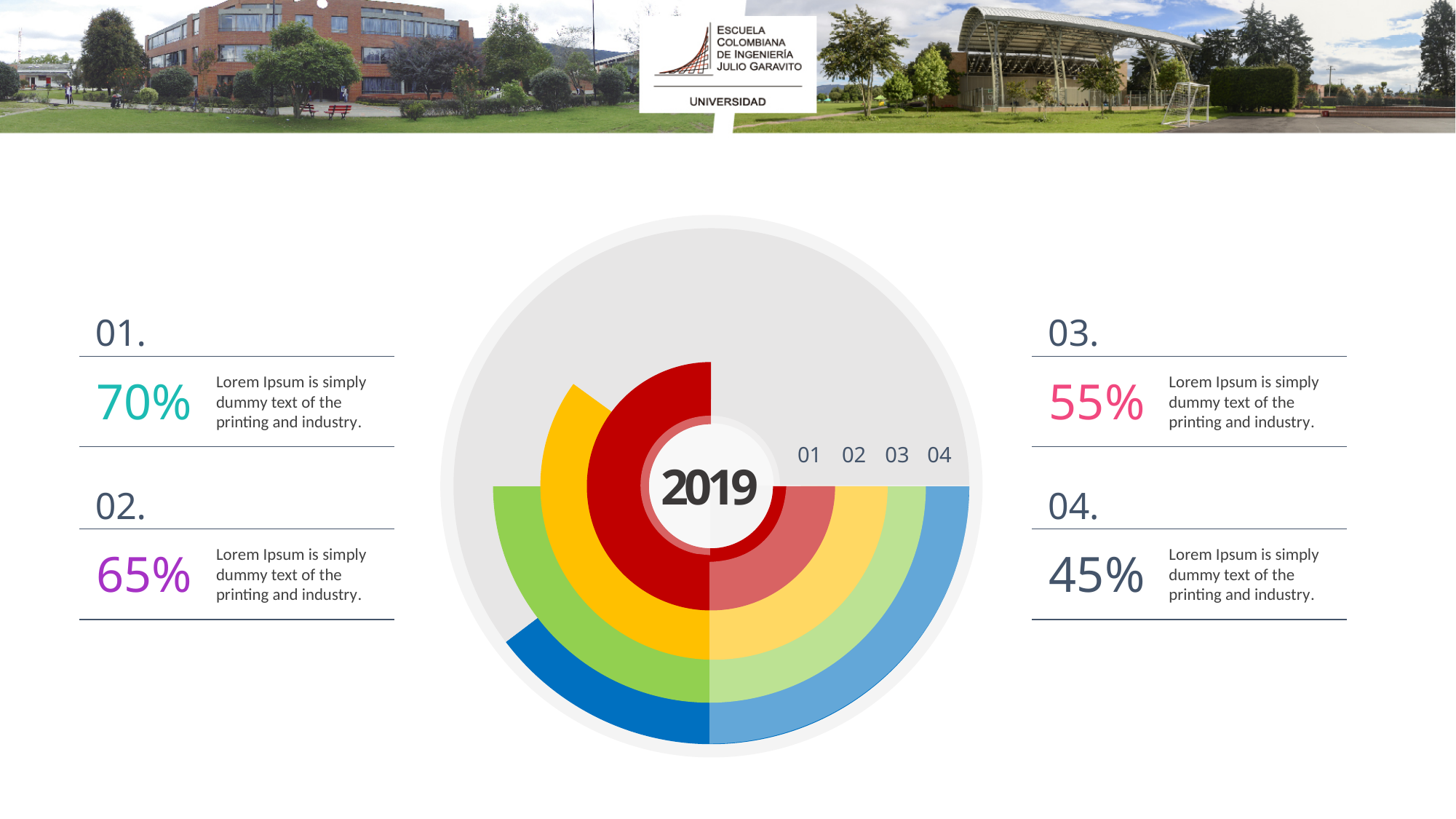
What kind of chart is shown on the slide? doughnut chart What value is shown for item 04? 45% Which item has the highest value? 01 What year is printed in the centre of the chart? 2019 What value is shown for item 01? 70% Which item has the lowest value? 04 Which is larger, the value for item 02 or the value for item 03? 02 How many numbered items (rings) does the chart show? 4 What value is shown for item 02? 65% What is the difference between the values for item 02 and item 03? 10% What value is shown for item 03? 55% What is the difference between the values for item 01 and item 04? 25%